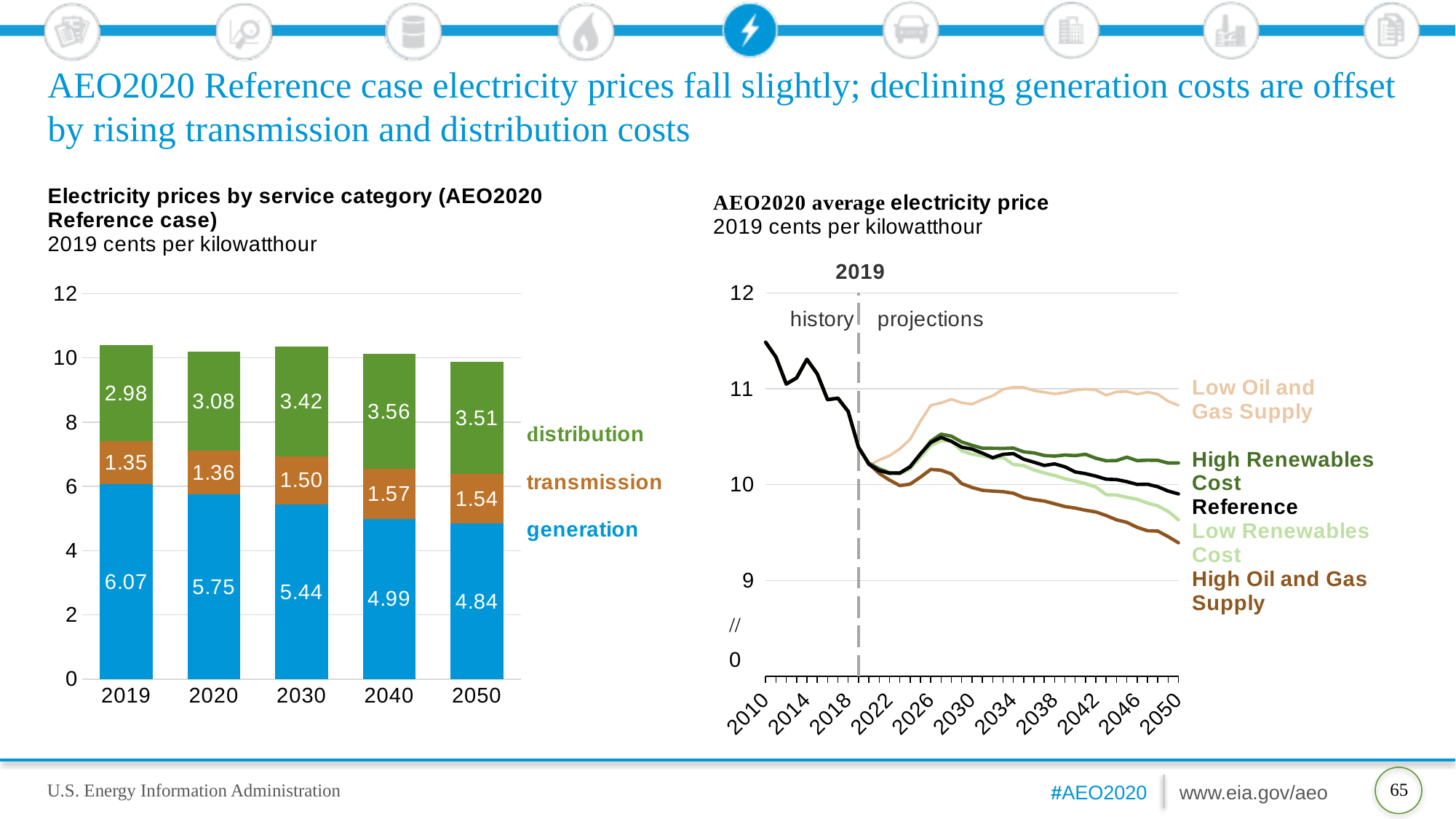
In the 'Electricity prices by service category' chart, what is the difference between the generation values for 2019 and 2050? 1.23 What kind of chart is the 'AEO2020 average electricity price' chart? line chart In the 'Electricity prices by service category' chart, what is the generation value for 2019? 6.07 In the 'AEO2020 average electricity price' chart, how many scenario lines are labelled? 5 In the 'Electricity prices by service category' chart, does the generation value rise or fall from 2019 to 2050? fall In the 'Electricity prices by service category' chart, what is the total of the stacked bar for 2019? 10.40 In the 'AEO2020 average electricity price' chart, is the High Oil and Gas Supply value in 2050 greater or less than 10? less In the 'Electricity prices by service category' chart, which year has the lowest generation value? 2050 In the 'Electricity prices by service category' chart, which year has the highest distribution value? 2040 In the 'Electricity prices by service category' chart, how many years are shown on the x axis? 5 In the 'Electricity prices by service category' chart, what is the distribution value for 2040? 3.56 In the 'Electricity prices by service category' chart, what is the transmission value for 2030? 1.50